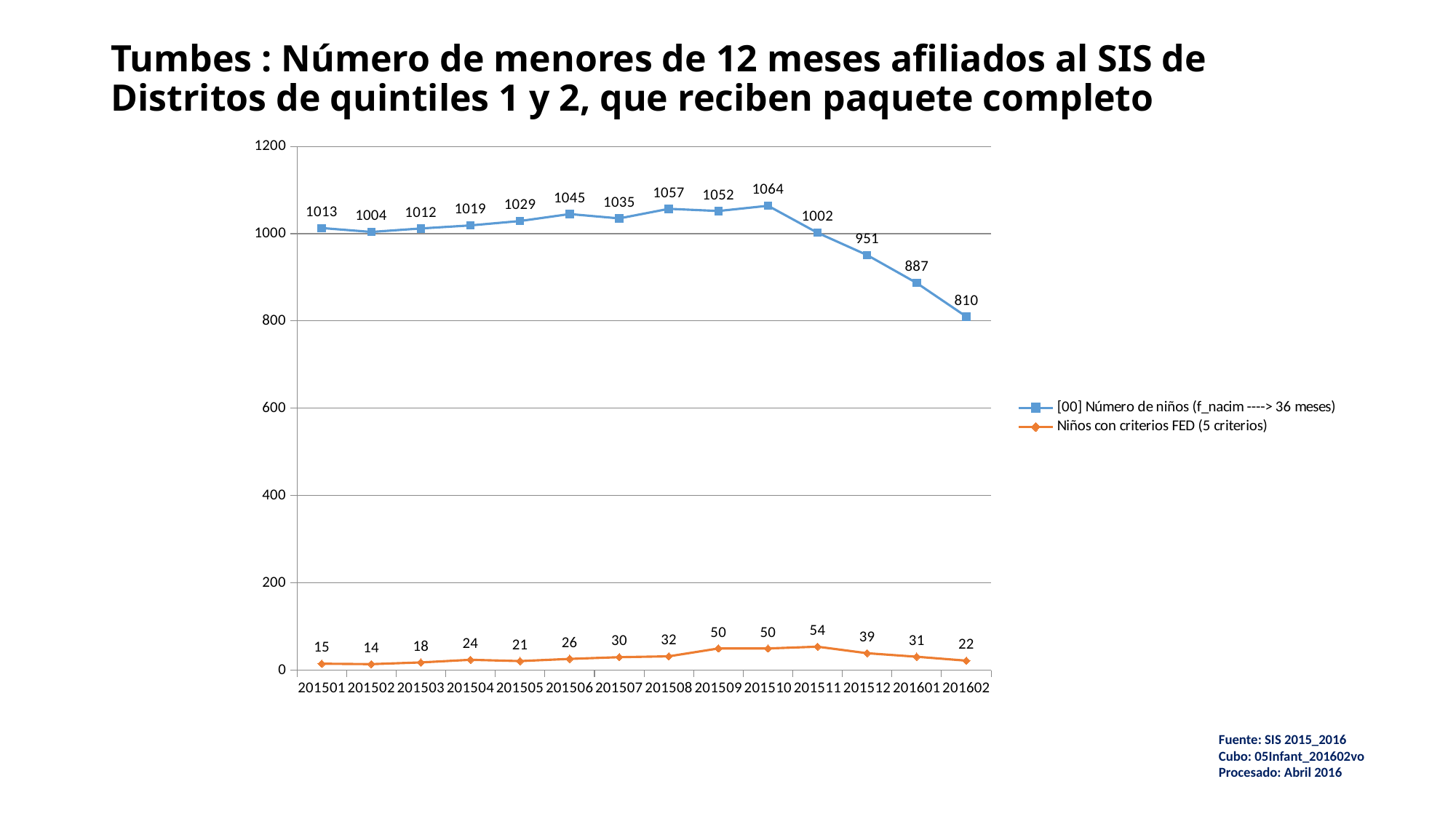
What kind of chart is shown on the slide? Line chart How many periods are shown on the x axis? 14 What is the value of the '[00] Número de niños (f_nacim ----> 36 meses)' series at 201602? 810 Does the '[00] Número de niños (f_nacim ----> 36 meses)' series rise or fall from 201510 to 201602? Fall How many series does the legend list? 2 Which is larger for the 'Niños con criterios FED (5 criterios)' series: the value at 201509 or at 201512? 201509 What is the value of the 'Niños con criterios FED (5 criterios)' series at 201511? 54 At which period does the 'Niños con criterios FED (5 criterios)' series have its lowest value? 201502 At which period does the 'Niños con criterios FED (5 criterios)' series reach its highest value? 201511 At which period does the '[00] Número de niños (f_nacim ----> 36 meses)' series reach its lowest value? 201602 What is the value of the '[00] Número de niños (f_nacim ----> 36 meses)' series at 201510? 1064 What is the difference between the '[00] Número de niños' values at 201510 and 201602? 254